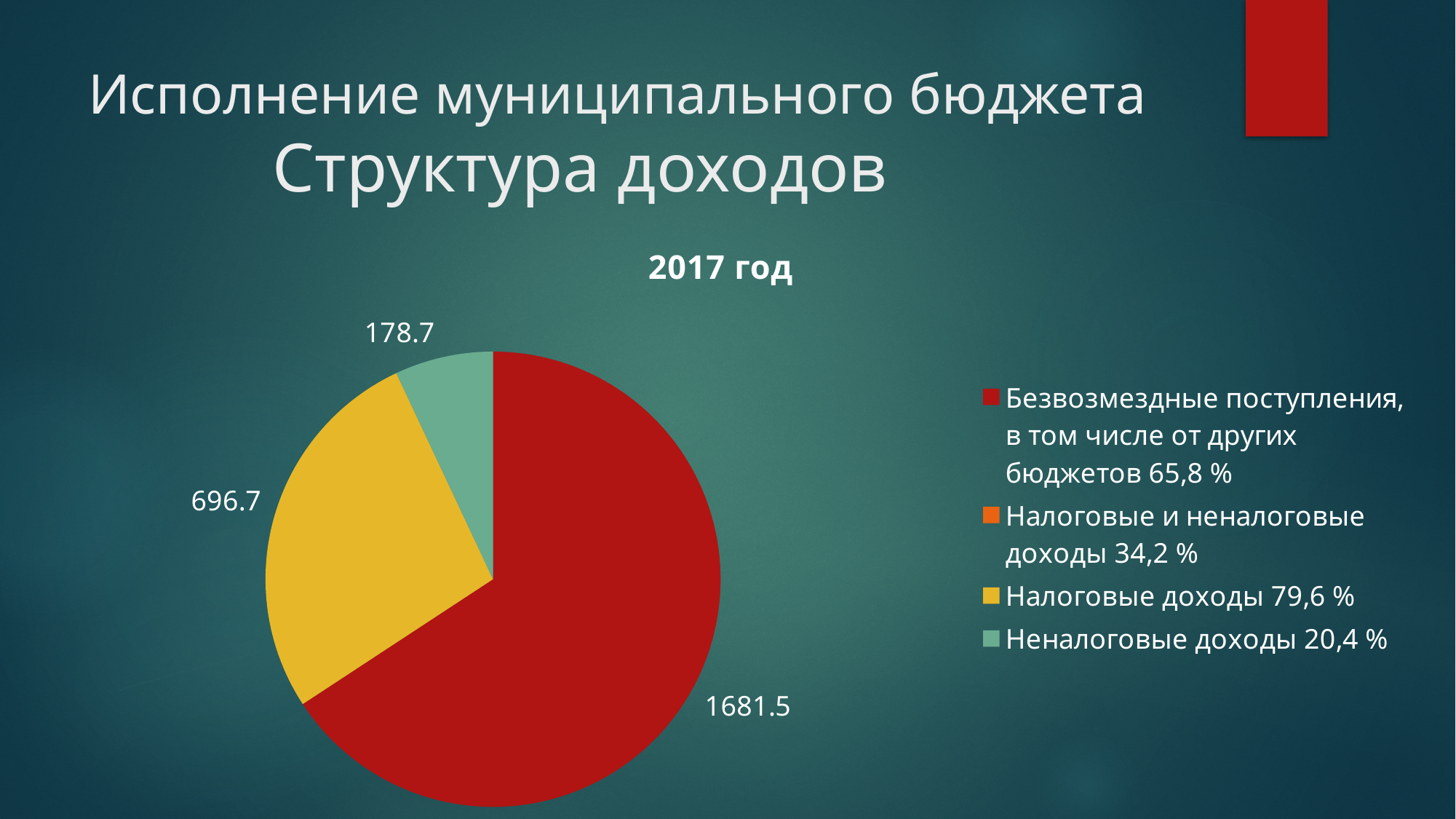
What value is shown for the red slice (Безвозмездные поступления, в том числе от других бюджетов)? 1681.5 Which category has the largest slice of the pie? Безвозмездные поступления, в том числе от других бюджетов What type of chart is shown on the slide? pie chart Which category has the smallest slice of the pie? Неналоговые доходы What is the title of the chart? 2017 год How many slices with data labels are visible in the pie? 3 How many entries does the legend list? 4 What value is shown for the yellow slice (Налоговые доходы)? 696.7 What is the difference between the values for Налоговые доходы (696.7) and Неналоговые доходы (178.7)? 518.0 What is the difference between the values for Безвозмездные поступления (1681.5) and Налоговые доходы (696.7)? 984.8 What value is shown for the green slice (Неналоговые доходы)? 178.7 Which is larger: the value for Налоговые доходы or the value for Неналоговые доходы? Налоговые доходы